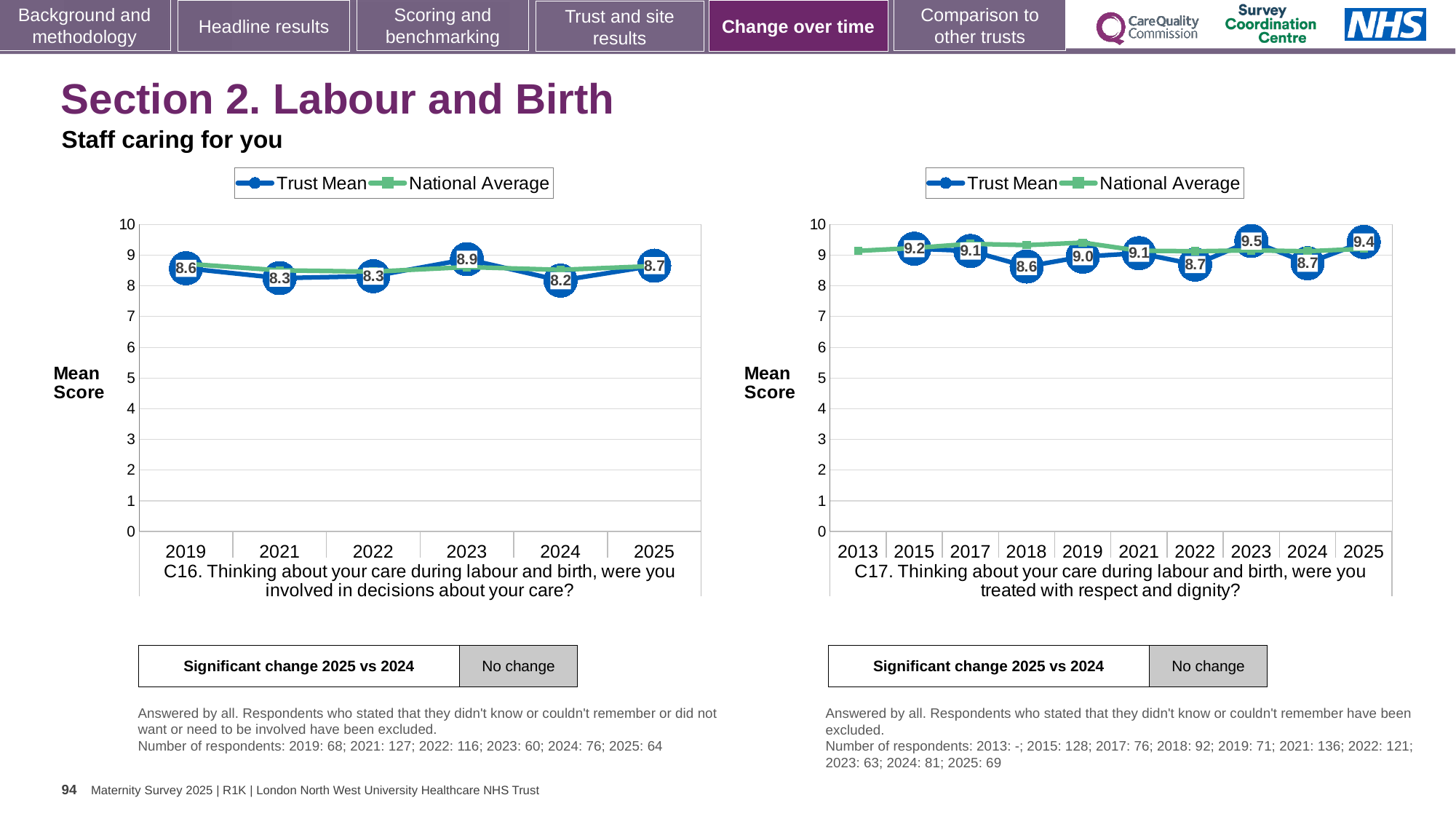
In the C16 chart on the left, which year has the lowest Trust Mean score? 2024 In the C17 chart on the right, how many years are shown on the x axis? 10 What type of chart is the C17 chart on the right? Line chart How many series does the legend of the C16 chart on the left list? 2 In the C16 chart on the left, what is the difference between the Trust Mean scores for 2023 and 2024? 0.7 In the C16 chart on the left, how many years are shown on the x axis? 6 In the C16 chart on the left, what is the Trust Mean score for 2025? 8.7 In the C17 chart on the right, what is the difference between the Trust Mean scores for 2023 and 2018? 0.9 In the C17 chart on the right, which year has the highest Trust Mean score? 2023 In the C16 chart on the left, what is the Trust Mean score for 2023? 8.9 In the C17 chart on the right, is the Trust Mean score for 2025 higher or lower than for 2024? higher In the C17 chart on the right, what is the Trust Mean score for 2018? 8.6